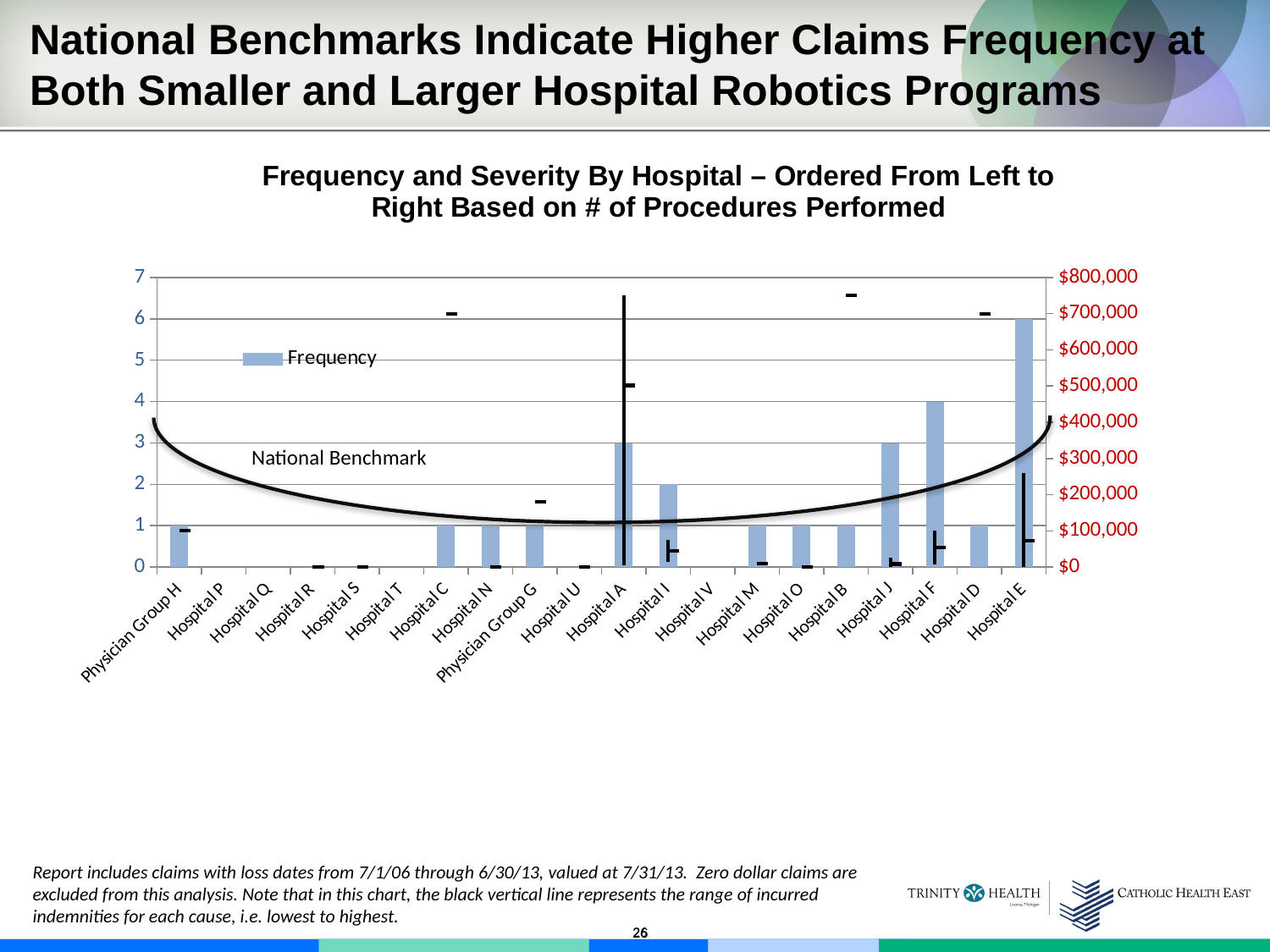
Which hospital has the highest Frequency bar? Hospital E What kind of chart is used to show Frequency? Bar chart What is the difference in Frequency between Hospital E and Hospital F? 2 What is the Frequency value for Hospital F? 4 How many series does the legend list? 1 What is the Frequency value for Hospital E? 6 Is the Frequency value for Hospital E greater or less than 5? greater What is the Frequency value for Hospital A? 3 Which has a higher Frequency, Hospital J or Hospital I? Hospital J What is the label of the black curved line on the chart? National Benchmark What is the Frequency value for Hospital I? 2 How many hospitals or physician groups are listed along the x axis? 20